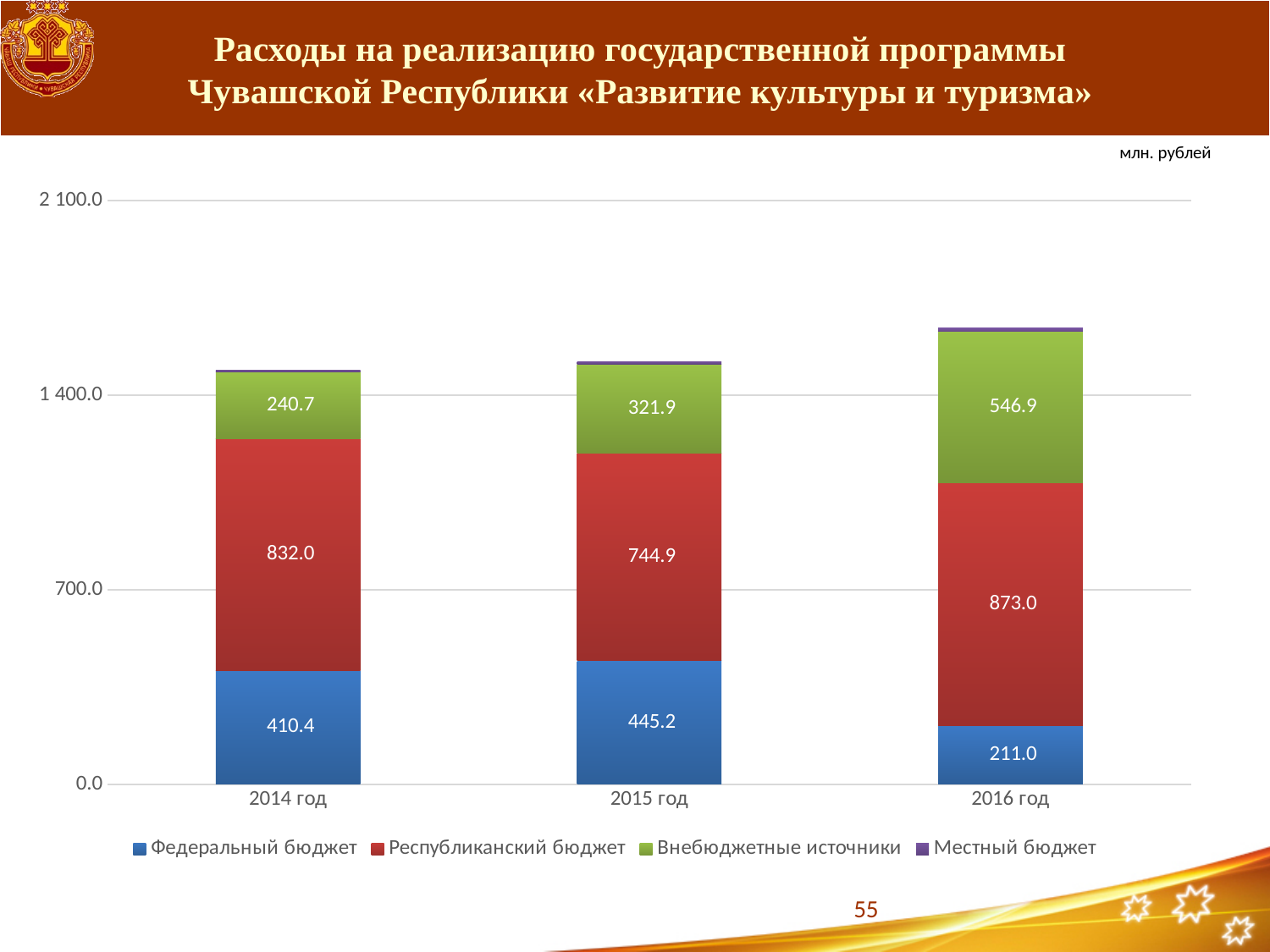
How many series does the legend list? 4 Which is larger: the Федеральный бюджет value for 2014 год or for 2015 год? 2015 год What kind of chart is shown on the slide? stacked bar chart Is the total height of the stacked bar for 2016 год greater or less than 1 400.0? greater How many years are shown on the x axis? 3 What is the difference between the Внебюджетные источники values for 2016 год and 2014 год? 306.2 What is the value for Федеральный бюджет in 2014 год? 410.4 In which year is the Федеральный бюджет value the lowest? 2016 год What is the value for Республиканский бюджет in 2015 год? 744.9 Do the Внебюджетные источники values rise or fall from 2014 год to 2016 год? rise What is the value for Внебюджетные источники in 2016 год? 546.9 In which year is the Республиканский бюджет value the highest? 2016 год